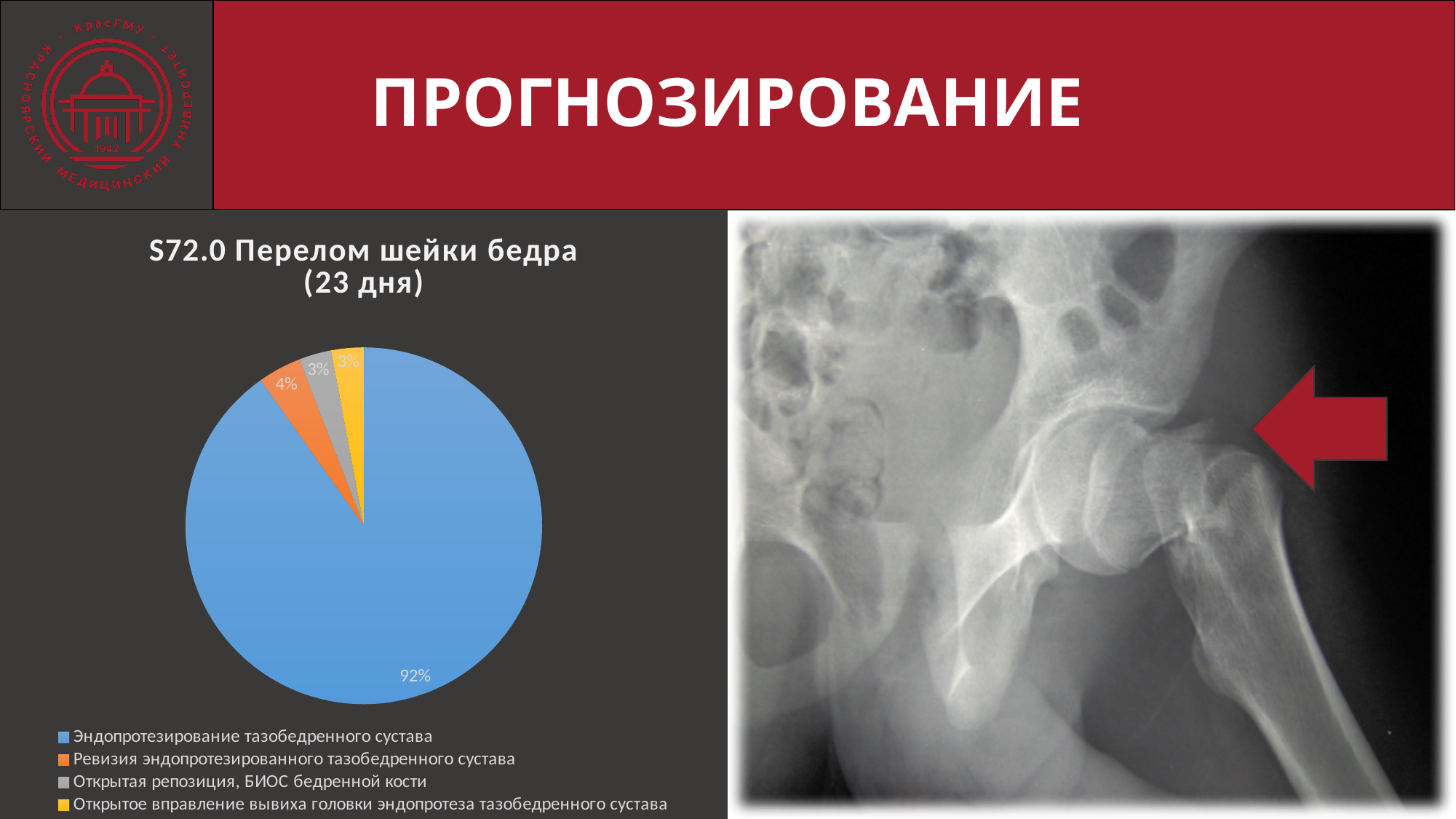
What is the difference in percentage points between Эндопротезирование тазобедренного сустава and Ревизия эндопротезированного тазобедренного сустава? 88 What share of the pie is Эндопротезирование тазобедренного сустава? 92% How many slices does the pie chart have? 4 Which is larger: the slice for Ревизия эндопротезированного тазобедренного сустава or the slice for Эндопротезирование тазобедренного сустава? Эндопротезирование тазобедренного сустава What share of the pie is Ревизия эндопротезированного тазобедренного сустава? 4% What is the title of the pie chart? S72.0 Перелом шейки бедра (23 дня) What share of the pie is Открытое вправление вывиха головки эндопротеза тазобедренного сустава? 3% How many entries does the legend of the pie chart list? 4 Which category is shown in orange in the pie chart? Ревизия эндопротезированного тазобедренного сустава Which category has the largest slice of the pie? Эндопротезирование тазобедренного сустава What kind of chart is shown on the slide? pie chart